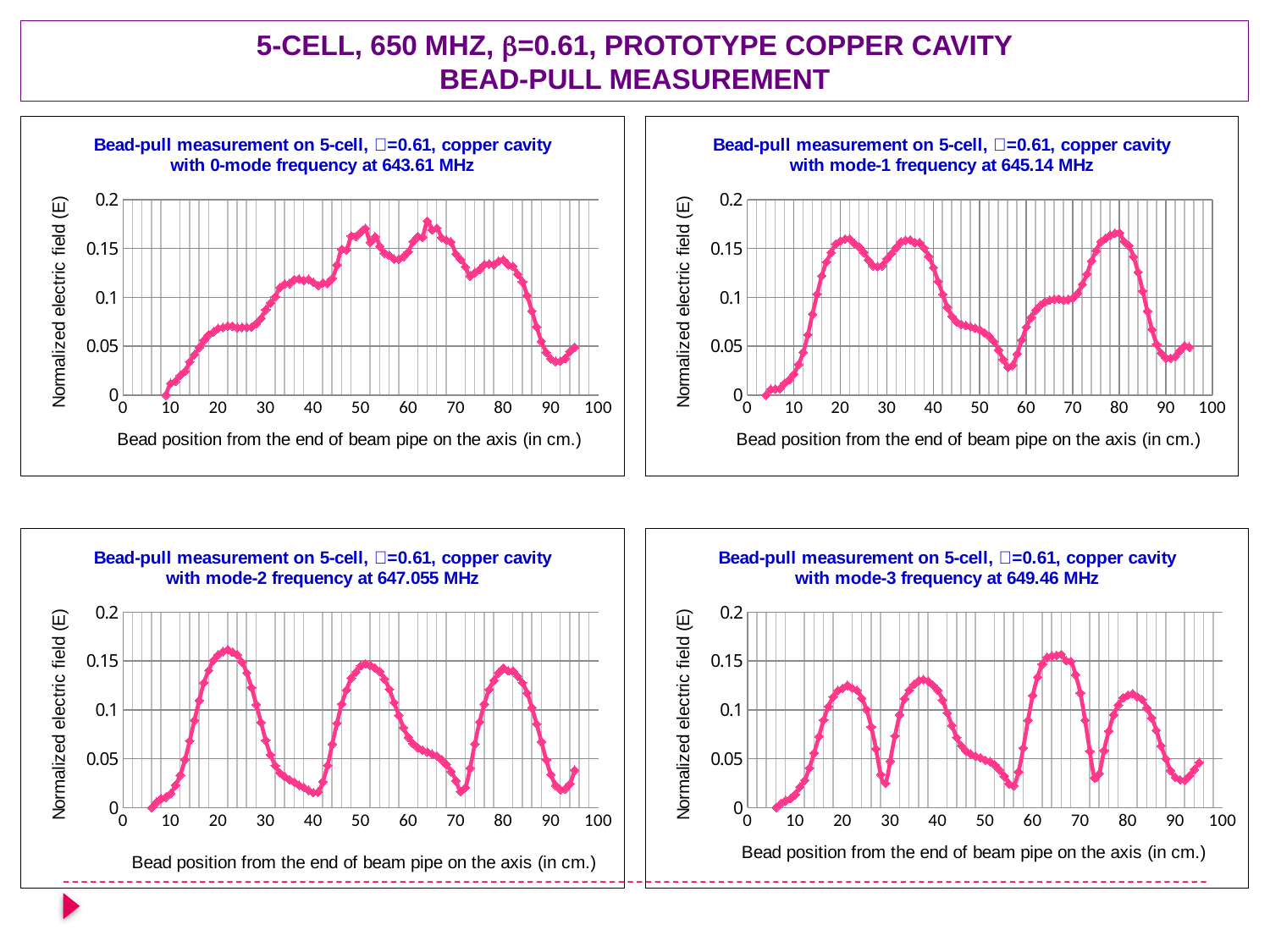
How many charts are shown on the slide? 4 In the top-left chart (0-mode), do the values rise or fall as the bead position goes from 10 cm to 50 cm? rise In the bottom-left chart, what mode-2 frequency is stated in the chart title? 647.055 MHz In the bottom-right chart (mode-3), do the values rise or fall as the bead position goes from 65 cm to 75 cm? fall In the top-right chart (mode-1), is the normalized electric field at a bead position of 10 cm greater or less than 0.05? less In the top-left chart (0-mode), is the normalized electric field at a bead position of 50 cm greater or less than 0.1? greater In the bottom-left chart (mode-2), is the normalized electric field at a bead position of 40 cm greater or less than 0.05? less In the top-right chart, what mode-1 frequency is stated in the chart title? 645.14 MHz What kind of chart is the top-left chart (0-mode frequency at 643.61 MHz)? line chart